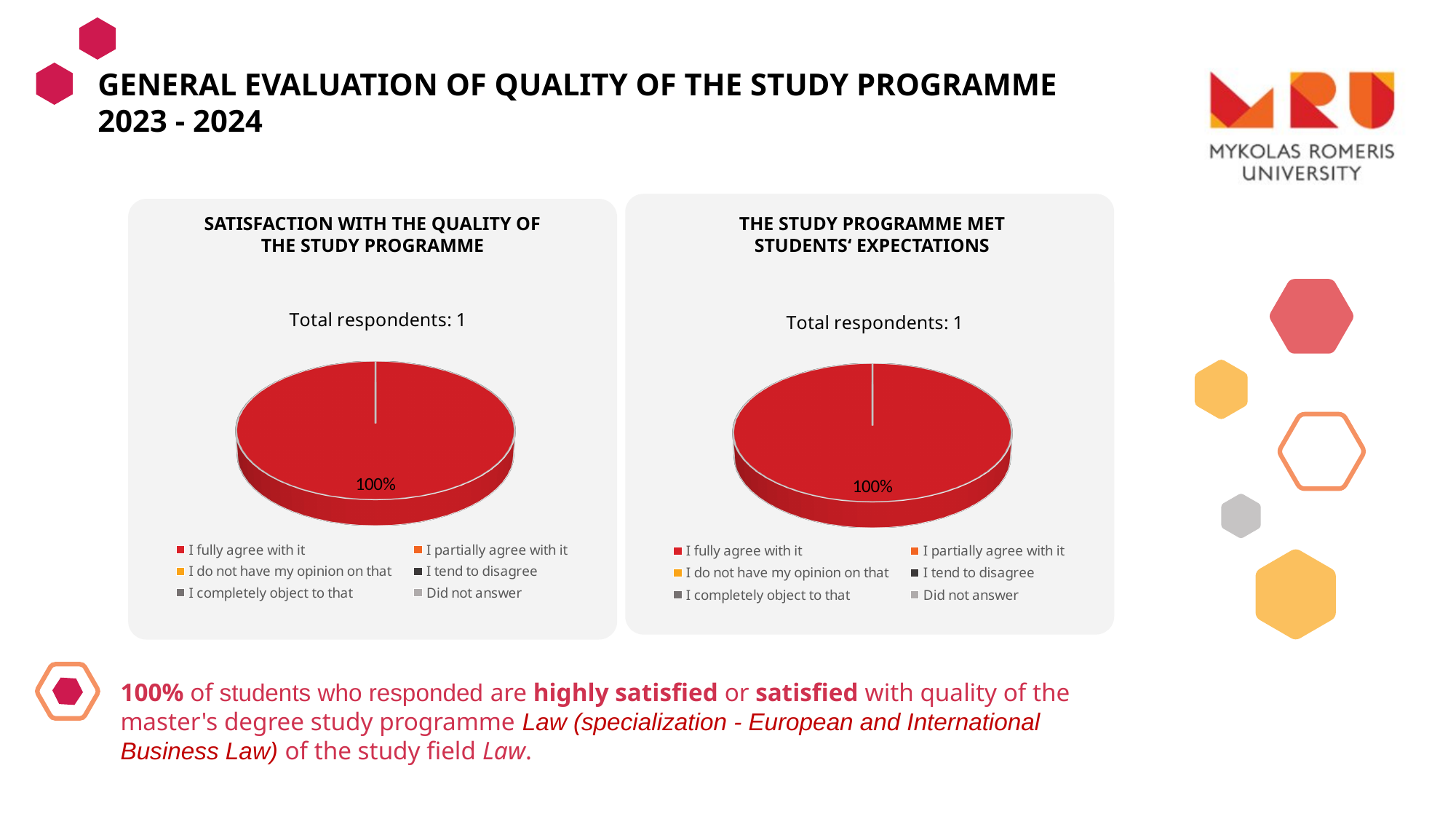
How many entries does the legend of the right chart, "The study programme met students' expectations", list? 6 What colour is the slice shown in the left chart, "Satisfaction with the quality of the study programme"? Red In the right chart, "The study programme met students' expectations", which category makes up the largest share of the pie? I fully agree with it How many total respondents are reported for the right chart, "The study programme met students' expectations"? 1 How many entries does the legend of the left chart, "Satisfaction with the quality of the study programme", list? 6 In the chart titled "Satisfaction with the quality of the study programme", what share of the pie is labelled "I fully agree with it"? 100% What kind of chart is the left chart, "Satisfaction with the quality of the study programme"? Pie chart What kind of chart is the right chart, "The study programme met students' expectations"? Pie chart In the left chart, "Satisfaction with the quality of the study programme", which category makes up the largest share of the pie? I fully agree with it What is the title of the chart on the right side of the slide? The study programme met students' expectations How many total respondents are reported for the left chart, "Satisfaction with the quality of the study programme"? 1 In the chart titled "The study programme met students' expectations", what share of the pie is labelled "I fully agree with it"? 100%